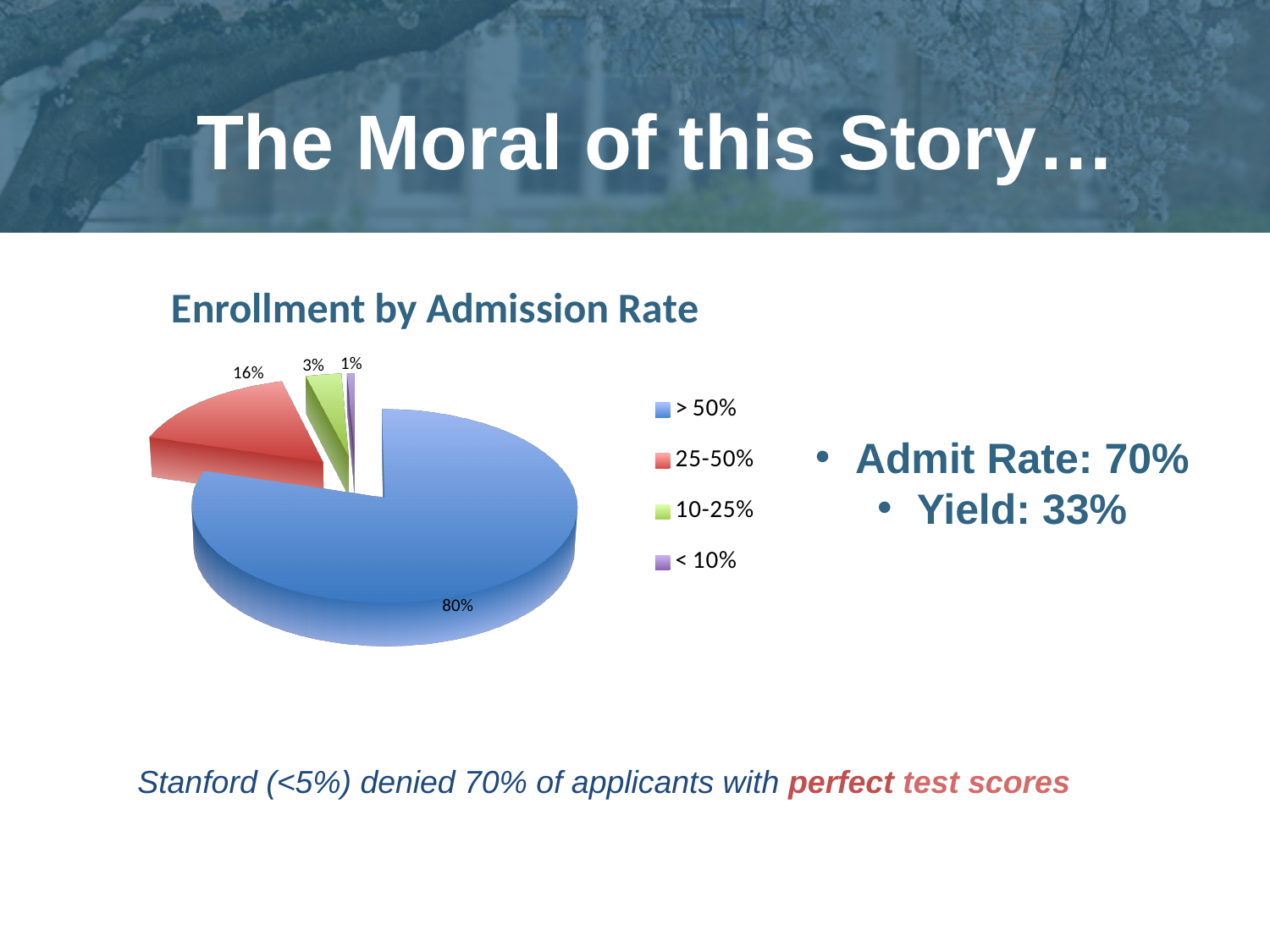
What is the title of the chart? Enrollment by Admission Rate What kind of chart is shown on the slide? pie chart What share of enrollment is in the 10-25% admission rate category? 3% What share of enrollment is in the < 10% admission rate category? 1% How many categories does the pie chart show? 4 Which category has a larger share, 25-50% or 10-25%? 25-50% What is the difference in percentage points between the > 50% and 25-50% categories? 64 What share of enrollment is in the 25-50% admission rate category? 16% What share of enrollment is in the > 50% admission rate category? 80% Which admission rate category has the smallest share of enrollment? < 10% Which admission rate category has the largest share of enrollment? > 50% What colour is the slice for the 25-50% category? red